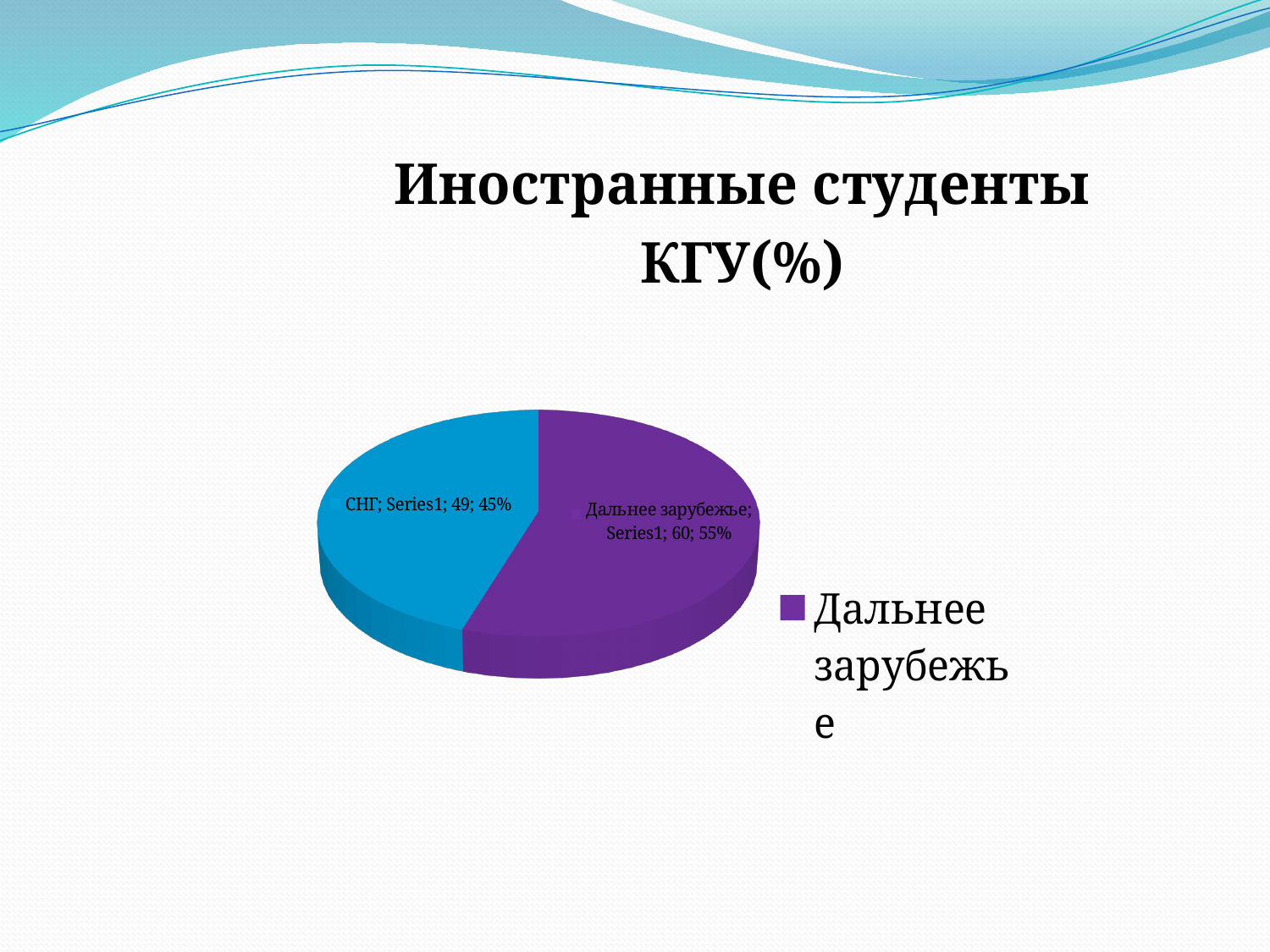
What is the value for Дальнее зарубежье? 60 What colour is the Дальнее зарубежье slice? purple What percentage share does the СНГ slice have? 45% How many slices does the pie chart have? 2 What is the difference between the values for Дальнее зарубежье and СНГ? 11 What percentage share does the Дальнее зарубежье slice have? 55% Which category has the largest slice? Дальнее зарубежье What is the title of the chart? Иностранные студенты КГУ(%) Which is larger, the value for СНГ or the value for Дальнее зарубежье? Дальнее зарубежье What is the value for СНГ? 49 What kind of chart is shown on the slide? pie chart Which category has the smallest slice? СНГ